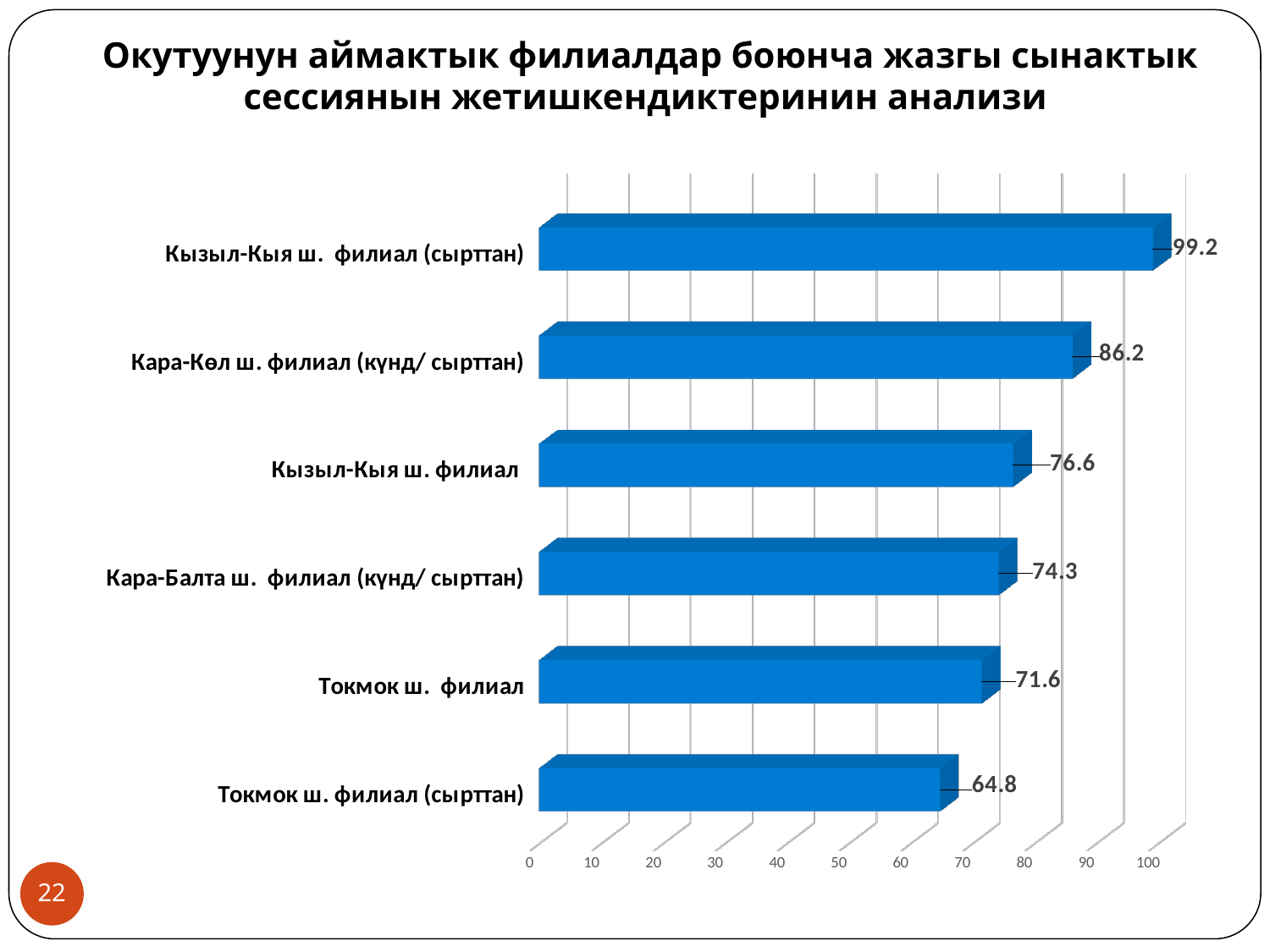
Which is larger, the value for Кызыл-Кыя ш. филиал or the value for Кара-Балта ш. филиал (күнд/ сырттан)? Кызыл-Кыя ш. филиал What is the value for Кызыл-Кыя ш. филиал (сырттан)? 99.2 What is the maximum value shown on the horizontal axis? 100 What kind of chart is shown on the slide? bar chart What is the value for Токмок ш. филиал? 71.6 Which category has the highest value? Кызыл-Кыя ш. филиал (сырттан) What is the difference between the values for Кызыл-Кыя ш. филиал (сырттан) and Кара-Көл ш. филиал (күнд/ сырттан)? 13 Is the value for Кара-Көл ш. филиал (күнд/ сырттан) greater or less than 80? greater What is the value for Кара-Балта ш. филиал (күнд/ сырттан)? 74.3 What is the difference between the values for Кызыл-Кыя ш. филиал and Токмок ш. филиал (сырттан)? 11.8 Which category has the lowest value? Токмок ш. филиал (сырттан) How many categories are shown in the chart? 6